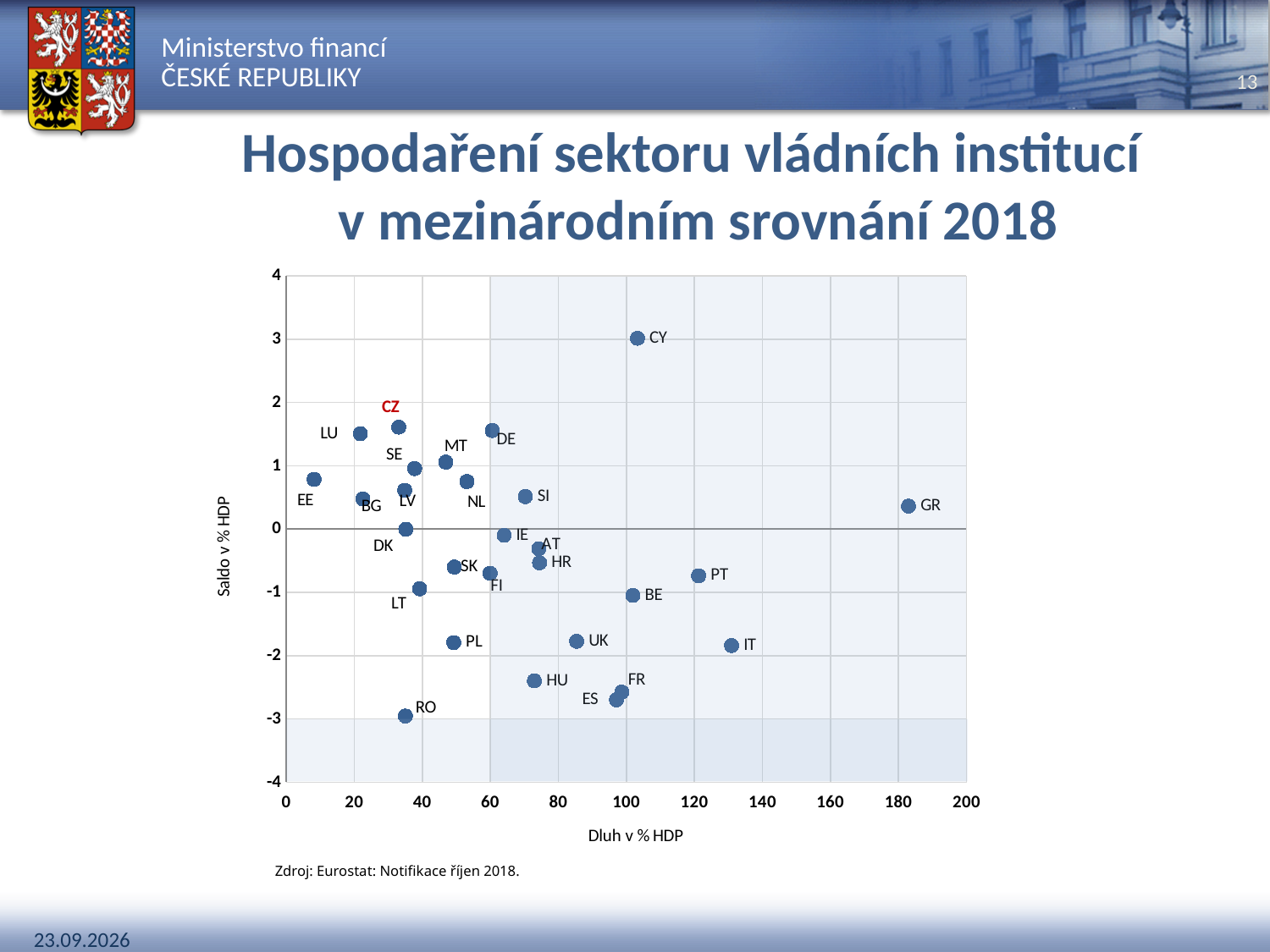
Which country has the highest value on the horizontal axis (Dluh v % HDP)? GR Which country has the lowest value on the horizontal axis (Dluh v % HDP)? EE What is the label of the horizontal axis of the chart? Dluh v % HDP Is the debt (Dluh v % HDP) value for GR greater or less than 160? greater Is the balance (Saldo v % HDP) value for CY greater or less than 2? greater Is the balance (Saldo v % HDP) value for RO greater or less than -2? less Which country has the highest value on the vertical axis (Saldo v % HDP)? CY Which has the higher debt (Dluh v % HDP), GR or IT? GR What kind of chart is shown on the slide? scatter chart Which has the higher balance (Saldo v % HDP), CZ or SE? CZ Which country has the lowest value on the vertical axis (Saldo v % HDP)? RO